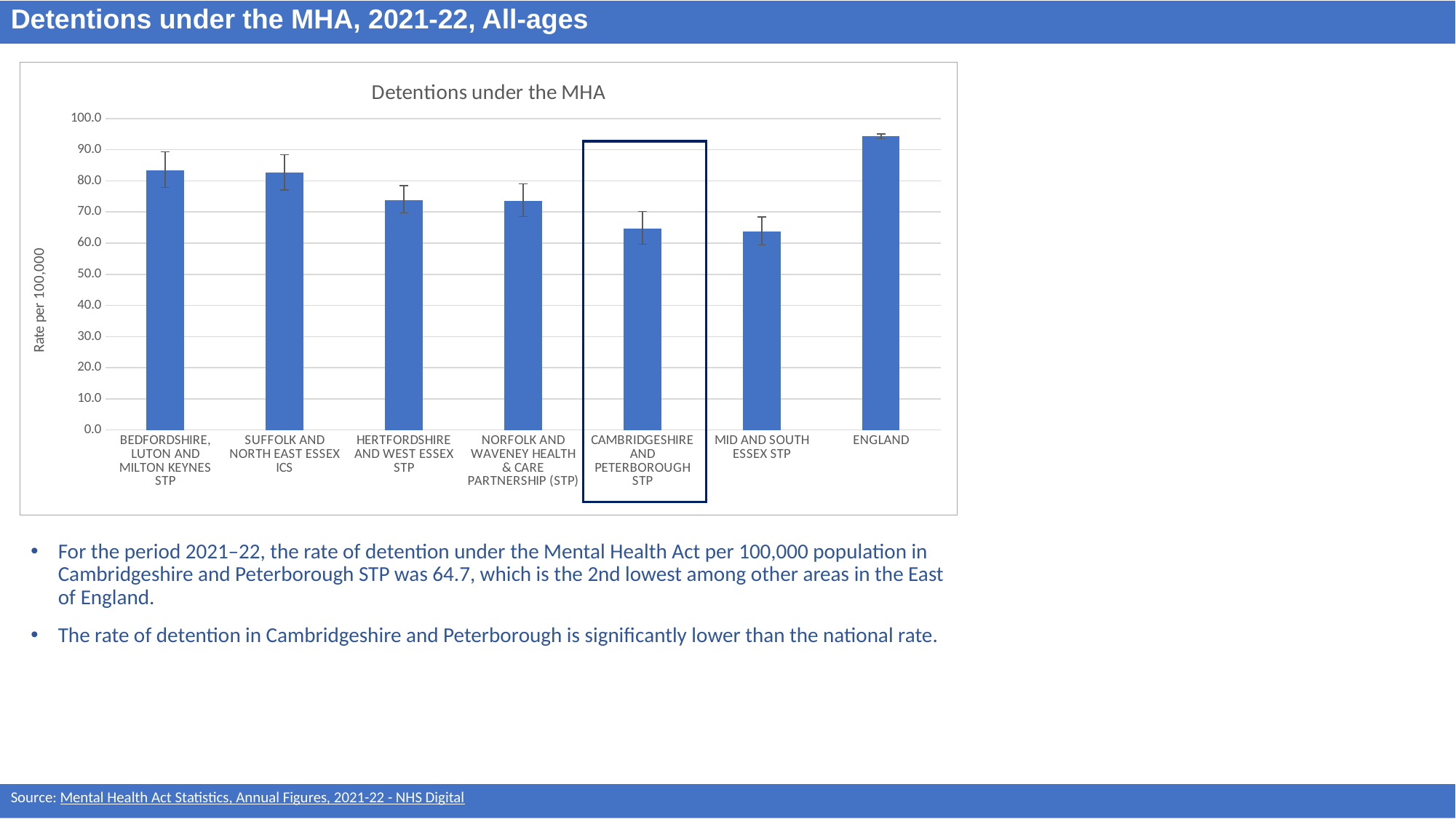
What kind of chart is shown on the slide? bar chart What is the label on the y axis of the chart? Rate per 100,000 Which has the larger value, ENGLAND or CAMBRIDGESHIRE AND PETERBOROUGH STP? ENGLAND Is the value for HERTFORDSHIRE AND WEST ESSEX STP greater or less than 70.0? greater Is the value for MID AND SOUTH ESSEX STP greater or less than 60.0? greater Which category has the highest detention rate in the chart? ENGLAND Is the value for CAMBRIDGESHIRE AND PETERBOROUGH STP greater or less than 70.0? less How many categories are plotted on the x axis of the chart? 7 Which has the larger value, BEDFORDSHIRE, LUTON AND MILTON KEYNES STP or HERTFORDSHIRE AND WEST ESSEX STP? BEDFORDSHIRE, LUTON AND MILTON KEYNES STP